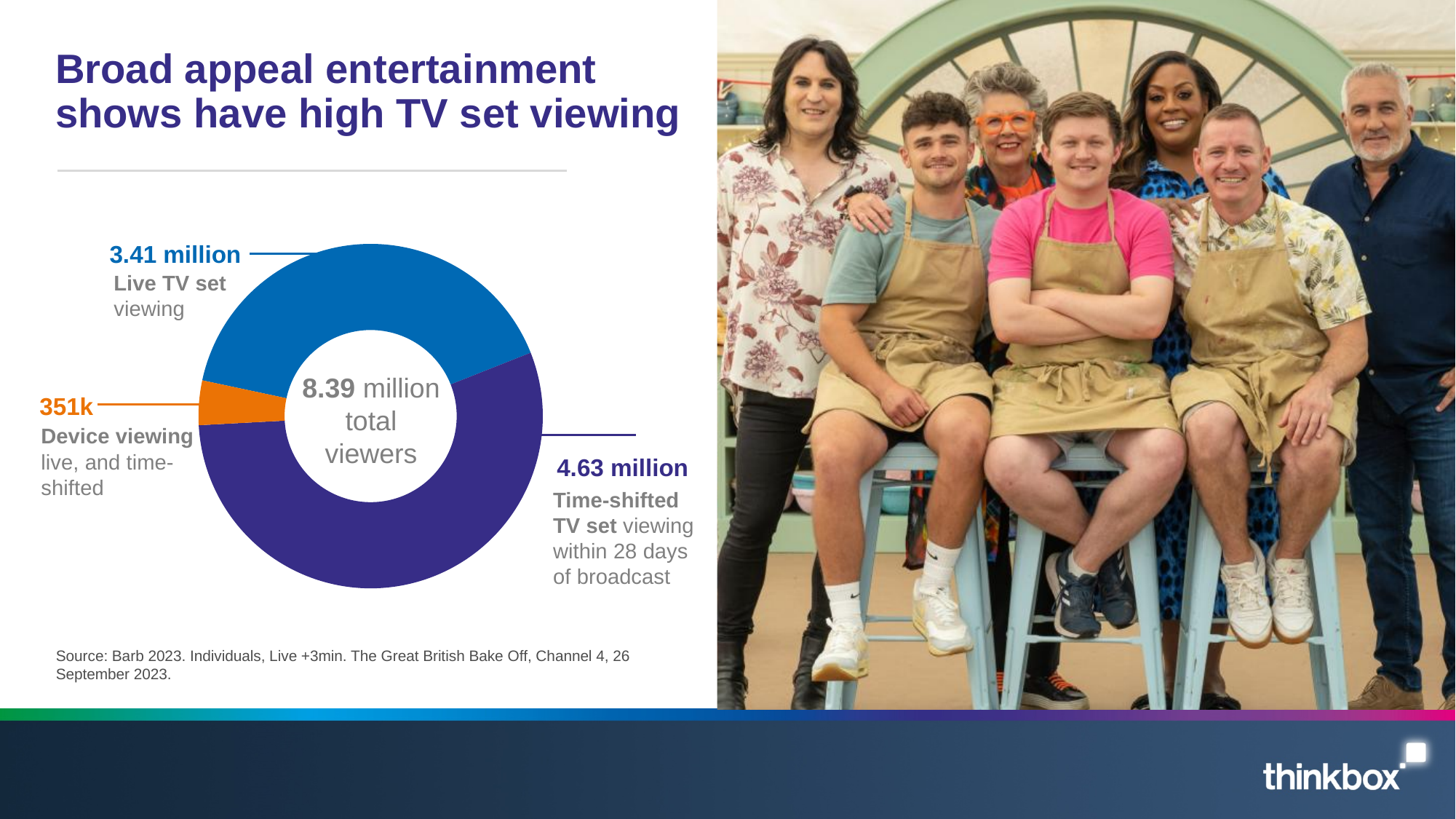
What is the total number of viewers shown in the centre of the chart? 8.39 million total viewers What is the value for Device viewing (live and time-shifted)? 351k What is the difference between Time-shifted TV set viewing and Live TV set viewing? 1.22 million How many segments does the chart have? 3 What is the title of the slide? Broad appeal entertainment shows have high TV set viewing Which is larger, Live TV set viewing or Time-shifted TV set viewing? Time-shifted TV set viewing What is the value for Time-shifted TV set viewing within 28 days of broadcast? 4.63 million Which segment of the chart is the smallest? Device viewing What is the value for Live TV set viewing? 3.41 million What kind of chart is shown on the slide? Pie chart (donut) What colour is the Device viewing segment? Orange Which segment of the chart is the largest? Time-shifted TV set viewing